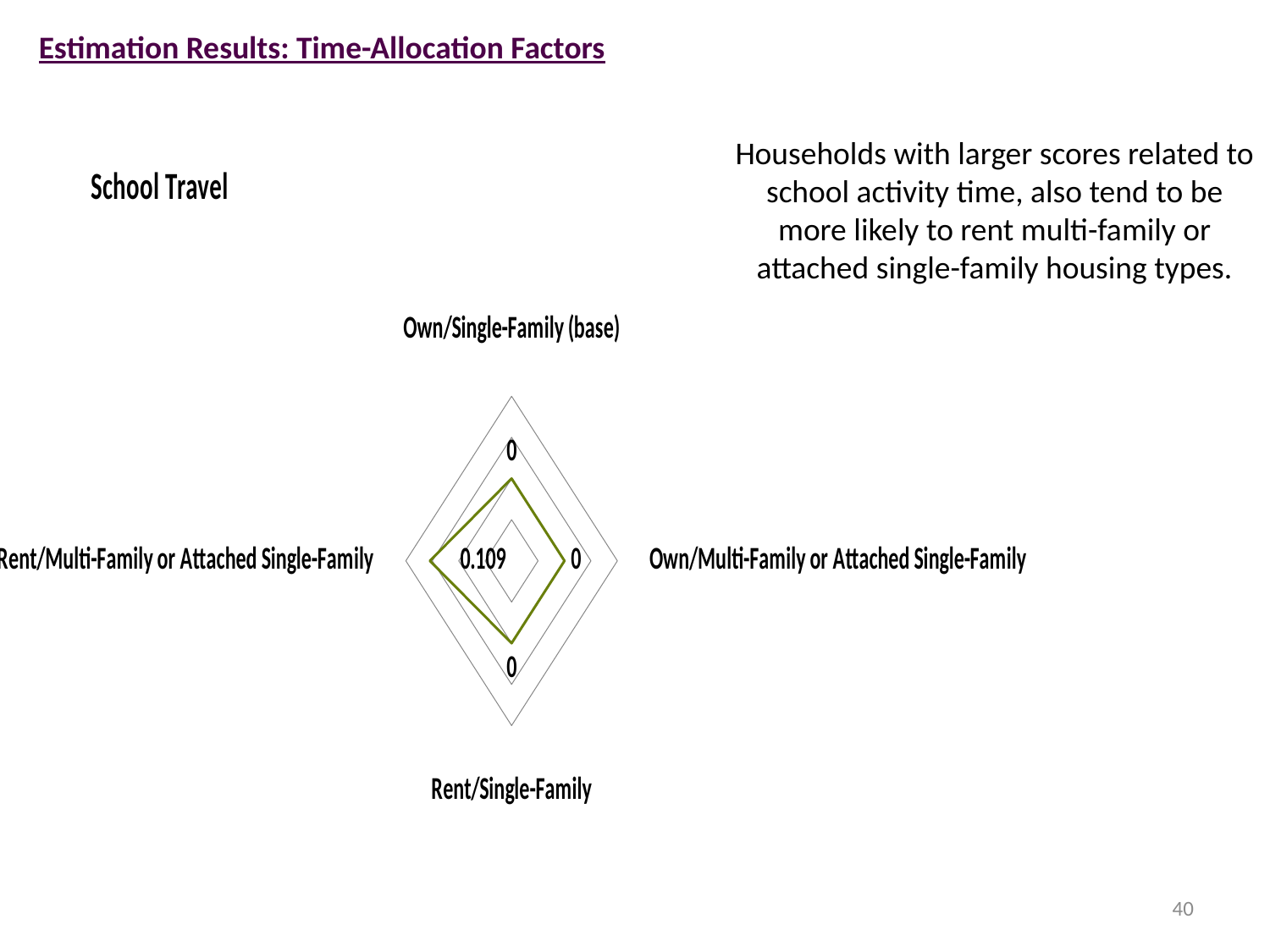
Which category is labelled as the base category? Own/Single-Family (base) What is the value for Own/Single-Family (base)? 0 What is the value for Own/Multi-Family or Attached Single-Family? 0 What is the title of the chart? School Travel Which is larger, the value for Rent/Multi-Family or Attached Single-Family or the value for Own/Multi-Family or Attached Single-Family? Rent/Multi-Family or Attached Single-Family How many categories have a value of 0? 3 How many categories does the radar chart have? 4 What is the difference between the value for Rent/Multi-Family or Attached Single-Family and the value for Rent/Single-Family? 0.109 What is the value for Rent/Single-Family? 0 What kind of chart is shown on the slide? radar chart What is the value for Rent/Multi-Family or Attached Single-Family? 0.109 Which category has the highest value? Rent/Multi-Family or Attached Single-Family